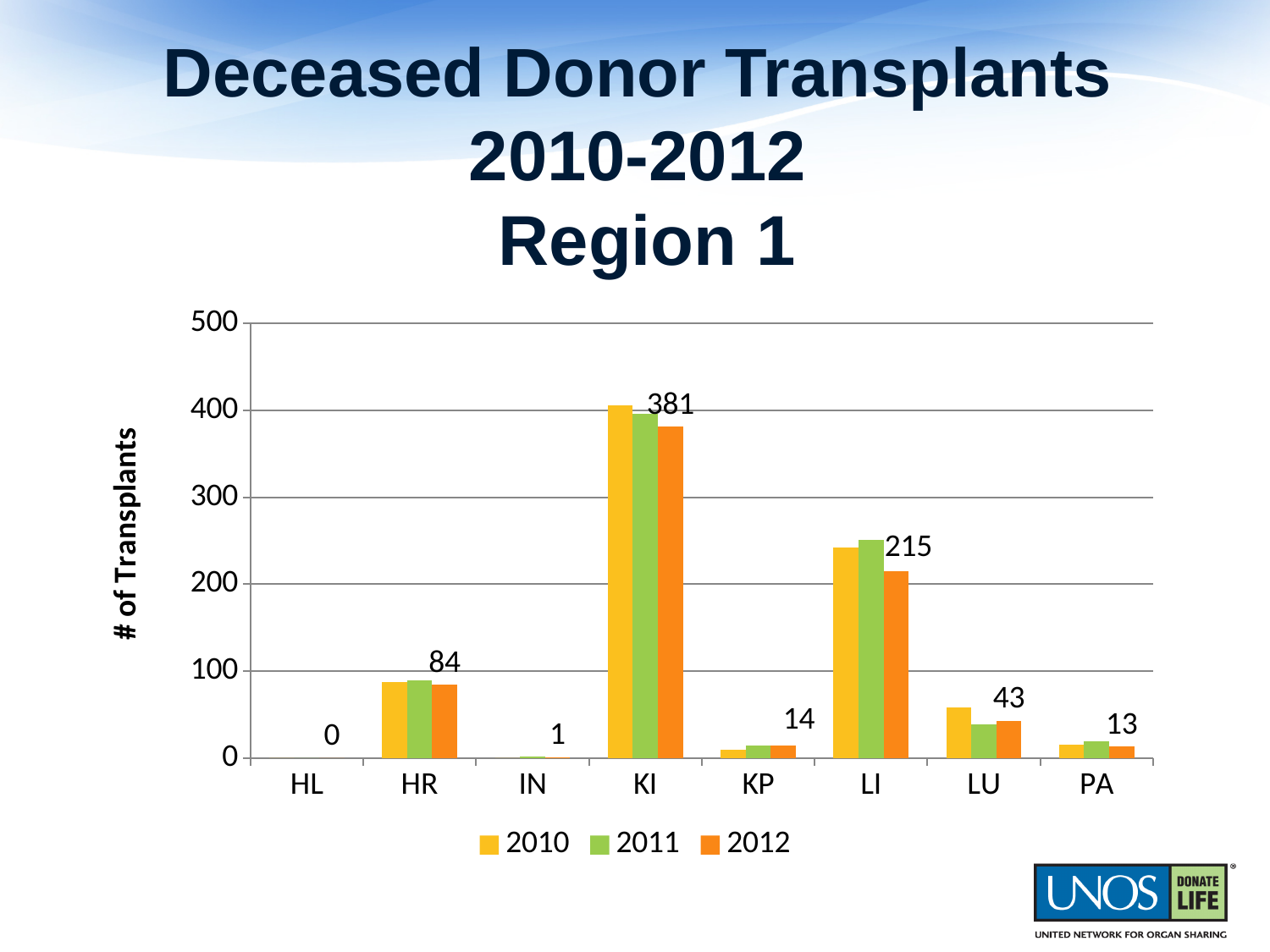
What is the 2012 value for KI? 381 Which category has the lowest 2012 value? HL Which is larger, the 2012 value for LU or the 2012 value for PA? LU How many categories are shown on the x axis? 8 What kind of chart is shown on the slide? bar chart What is the 2012 value for LI? 215 How many series does the legend list? 3 What is the 2012 value for LU? 43 What is the difference between the 2012 values for KI and LI? 166 Is the 2010 value for KI greater or less than 300? greater Which category has the highest 2012 value? KI What is the 2012 value for HR? 84